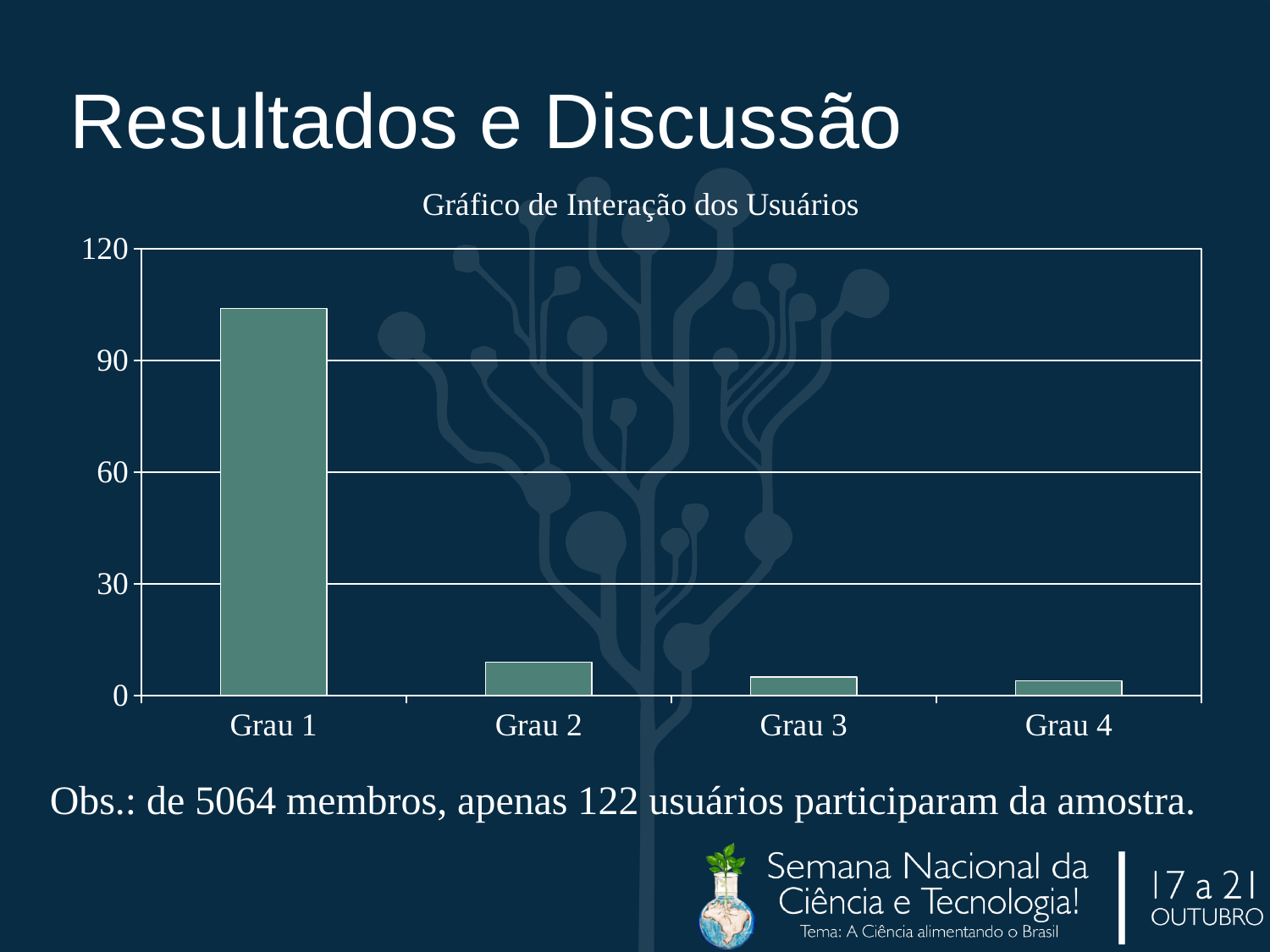
Which category has the highest value in the chart? Grau 1 Is the value for Grau 1 greater or less than 90? greater Is the value for Grau 3 greater or less than 30? less Is the value for Grau 2 greater or less than 30? less What is the title of the chart? Gráfico de Interação dos Usuários What kind of chart is shown on the slide? bar chart Which has a larger value, Grau 2 or Grau 3? Grau 2 What is the highest value shown on the y axis of the chart? 120 How many categories are shown on the x axis of the chart? 4 Do the values rise or fall from Grau 1 to Grau 4? fall Which has a larger value, Grau 1 or Grau 2? Grau 1